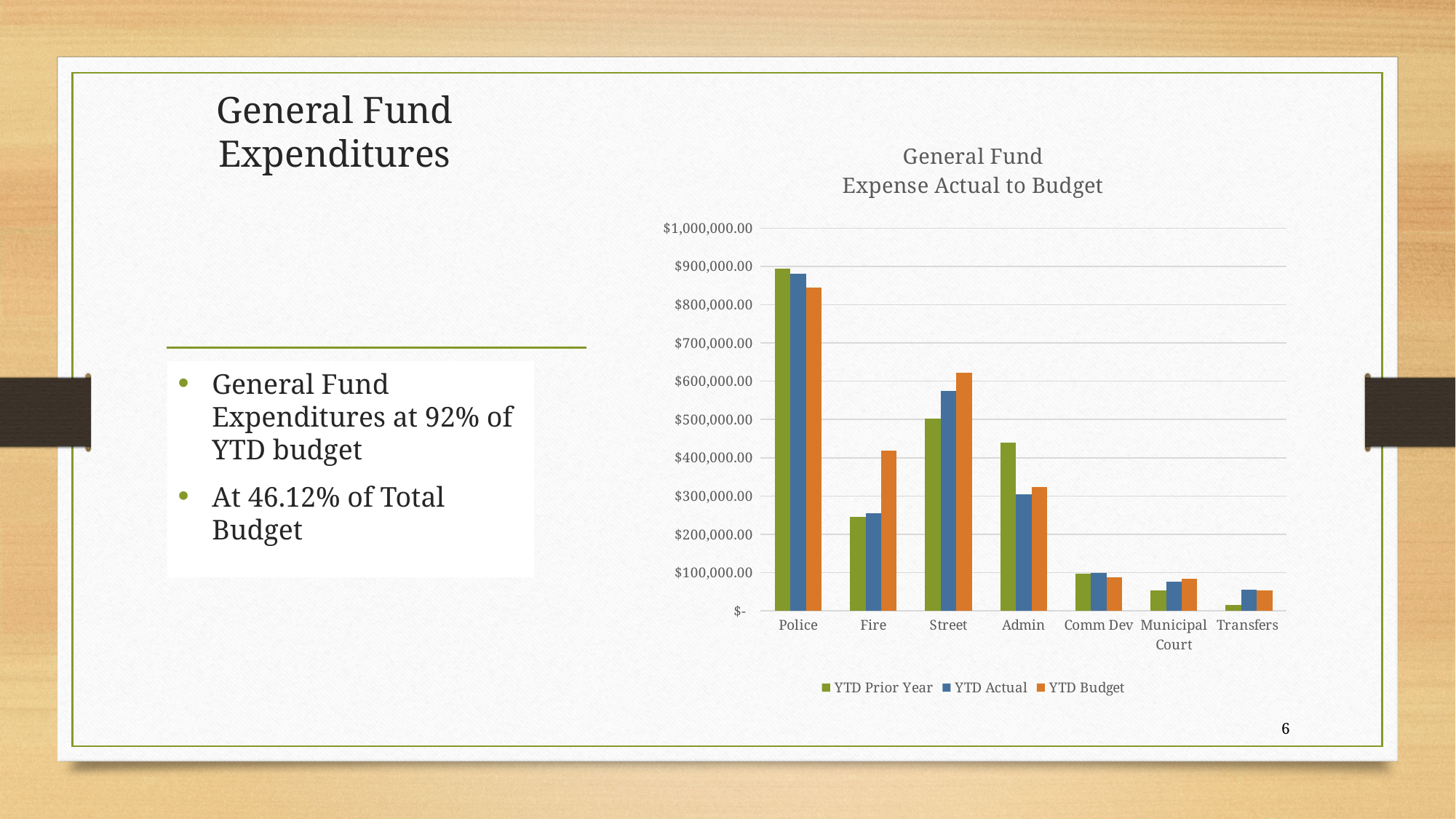
For Fire, which is larger: YTD Budget or YTD Actual? YTD Budget Which category has the lowest YTD Prior Year value? Transfers Is the YTD Actual value for Admin greater or less than $400,000.00? less Is the YTD Budget value for Police greater or less than $800,000.00? greater Which colour represents the YTD Budget series in the chart? Orange How many series does the chart legend list? 3 How many expenditure categories are shown along the x axis of the chart? 7 What kind of chart is shown on the slide? Bar chart Which category has the highest YTD Actual value? Police What is the title of the chart? General Fund Expense Actual to Budget For Admin, which is larger: YTD Prior Year or YTD Actual? YTD Prior Year Is the YTD Actual value for Street greater or less than $500,000.00? greater